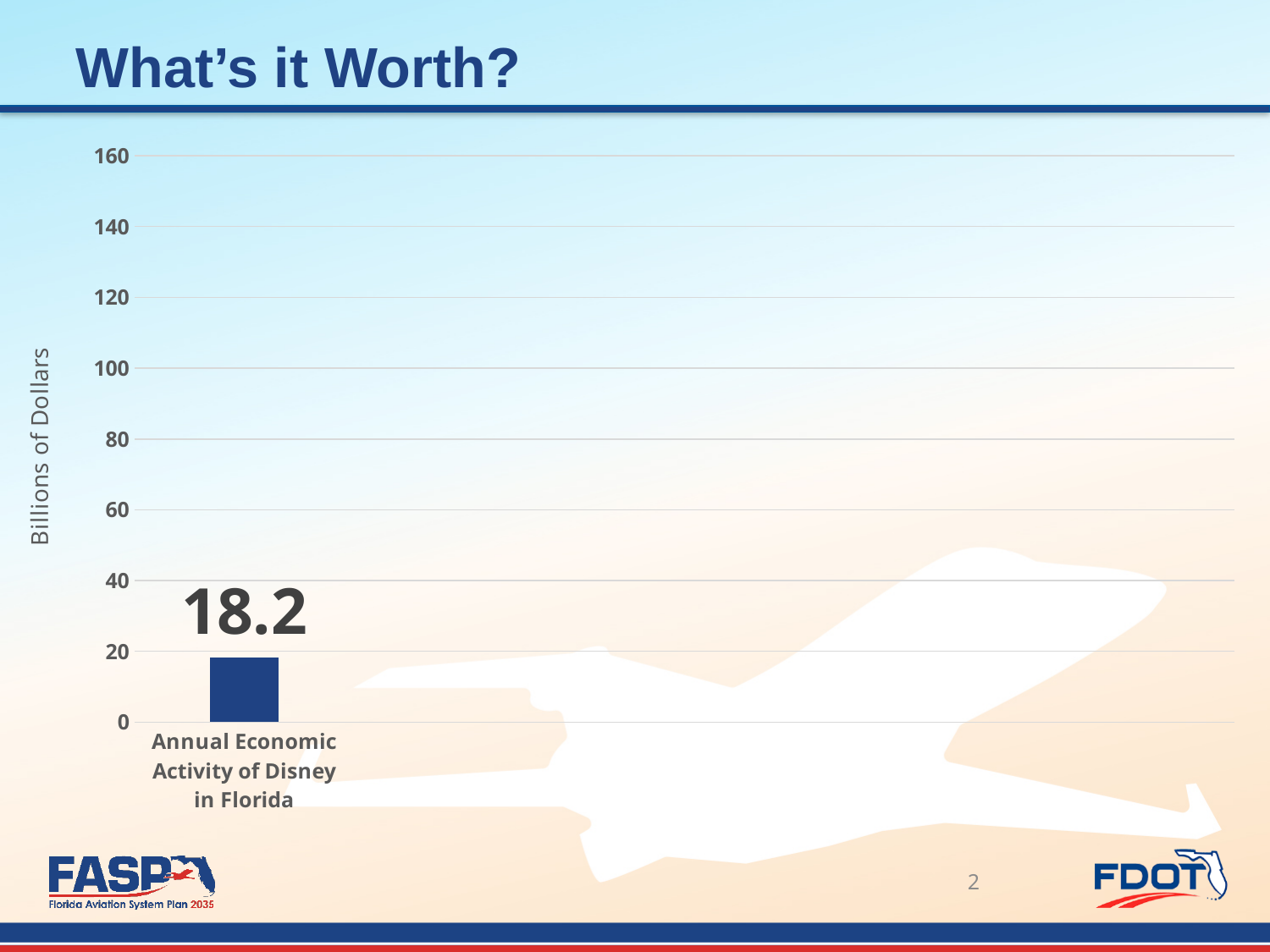
What is the value for Annual Economic Activity of Disney in Florida? 18.2 Is the value for Annual Economic Activity of Disney in Florida greater or less than 100? less What is the label of the y axis? Billions of Dollars Is the value for Annual Economic Activity of Disney in Florida greater or less than 20? less What is the highest value shown on the y axis? 160 What kind of chart is shown on the slide? bar chart How many bars are plotted in the chart? 1 What is the label of the single category on the x axis? Annual Economic Activity of Disney in Florida